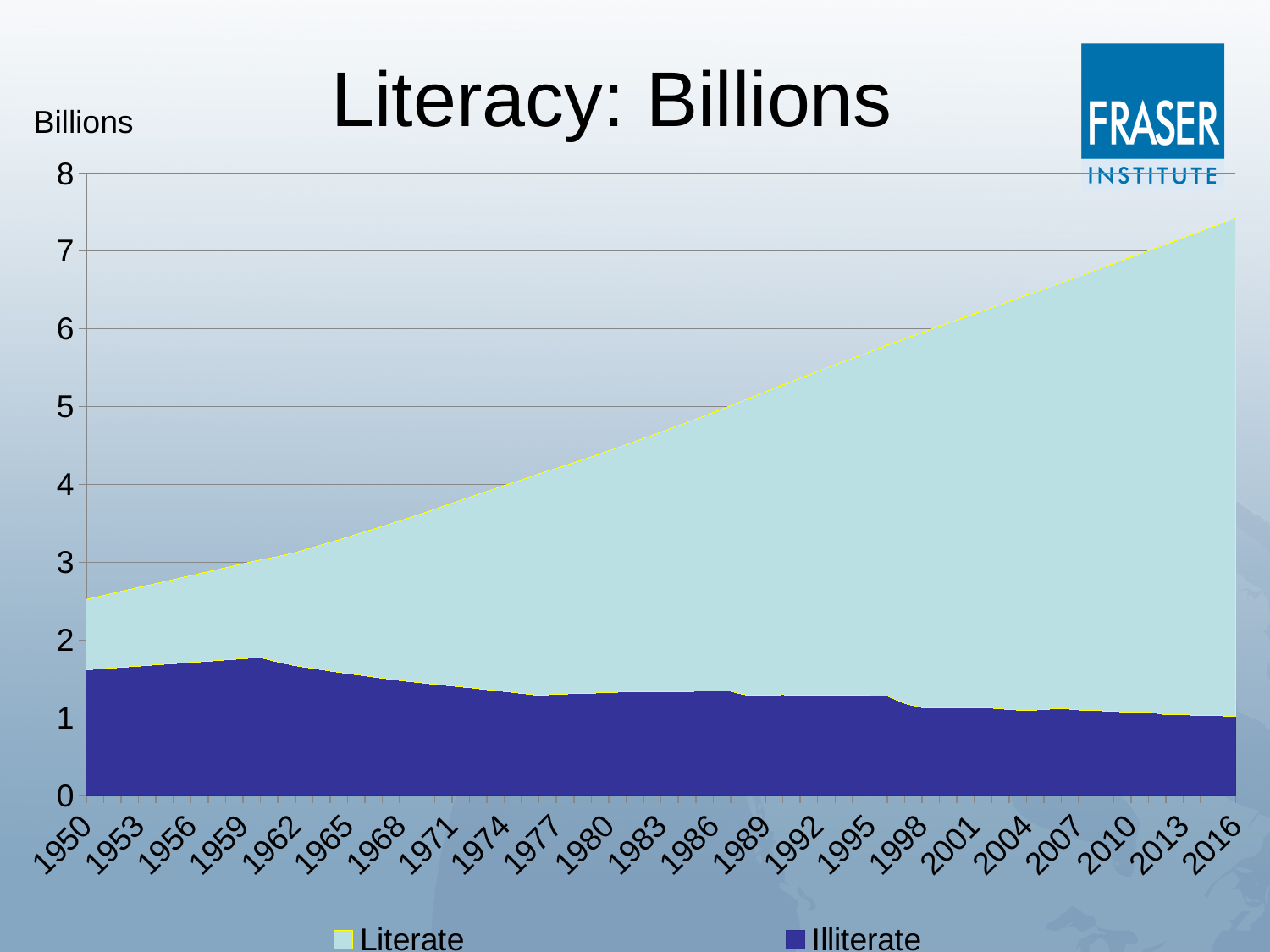
Is the Illiterate value in 2016 greater or less than 2? less How many series does the legend list? 2 Does the total (Literate plus Illiterate) rise or fall from 1950 to 2016? Rise Which is larger, the Illiterate value in 1950 or the Illiterate value in 2016? 1950 Is the total stacked value in 1950 greater or less than 3? less Is the Illiterate value in 1950 greater or less than 1? greater How many year labels are shown on the x axis? 23 What kind of chart is shown on the slide? Stacked area chart What is the title of the chart? Literacy: Billions What are the two series named in the legend? Literate and Illiterate